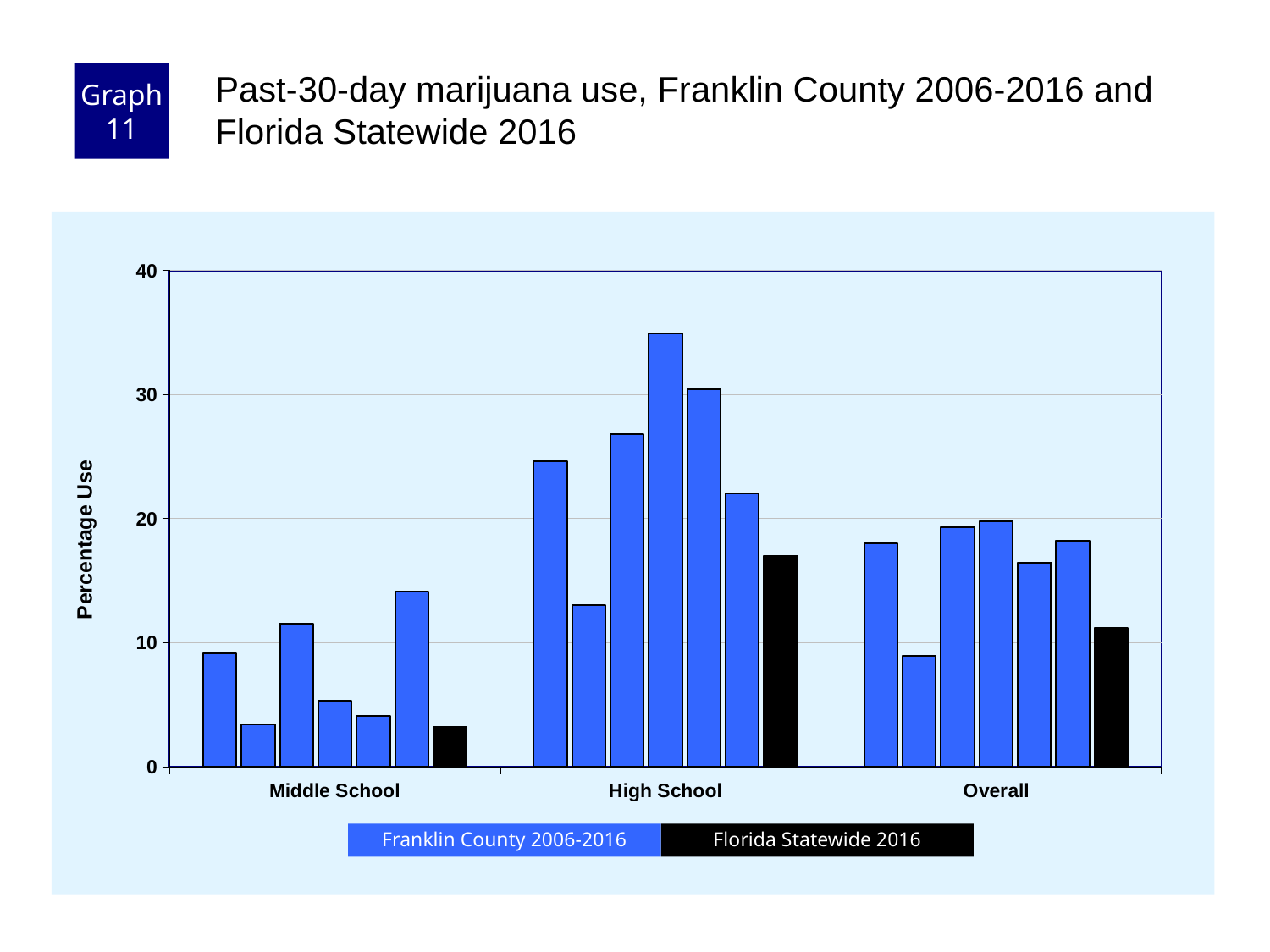
Is the Florida Statewide 2016 value for High School greater or less than 10? greater What is the label of the y axis? Percentage Use Which category has the tallest bar overall? High School Is the Florida Statewide 2016 value for Middle School greater or less than 10? less Which colour represents Florida Statewide 2016 in the legend? black How many series does the legend list? 2 Is the Florida Statewide 2016 value for Overall greater or less than 20? less What kind of chart is shown on the slide? bar chart How many categories are shown on the x axis? 3 Which is larger, the Florida Statewide 2016 value for High School or for Middle School? High School